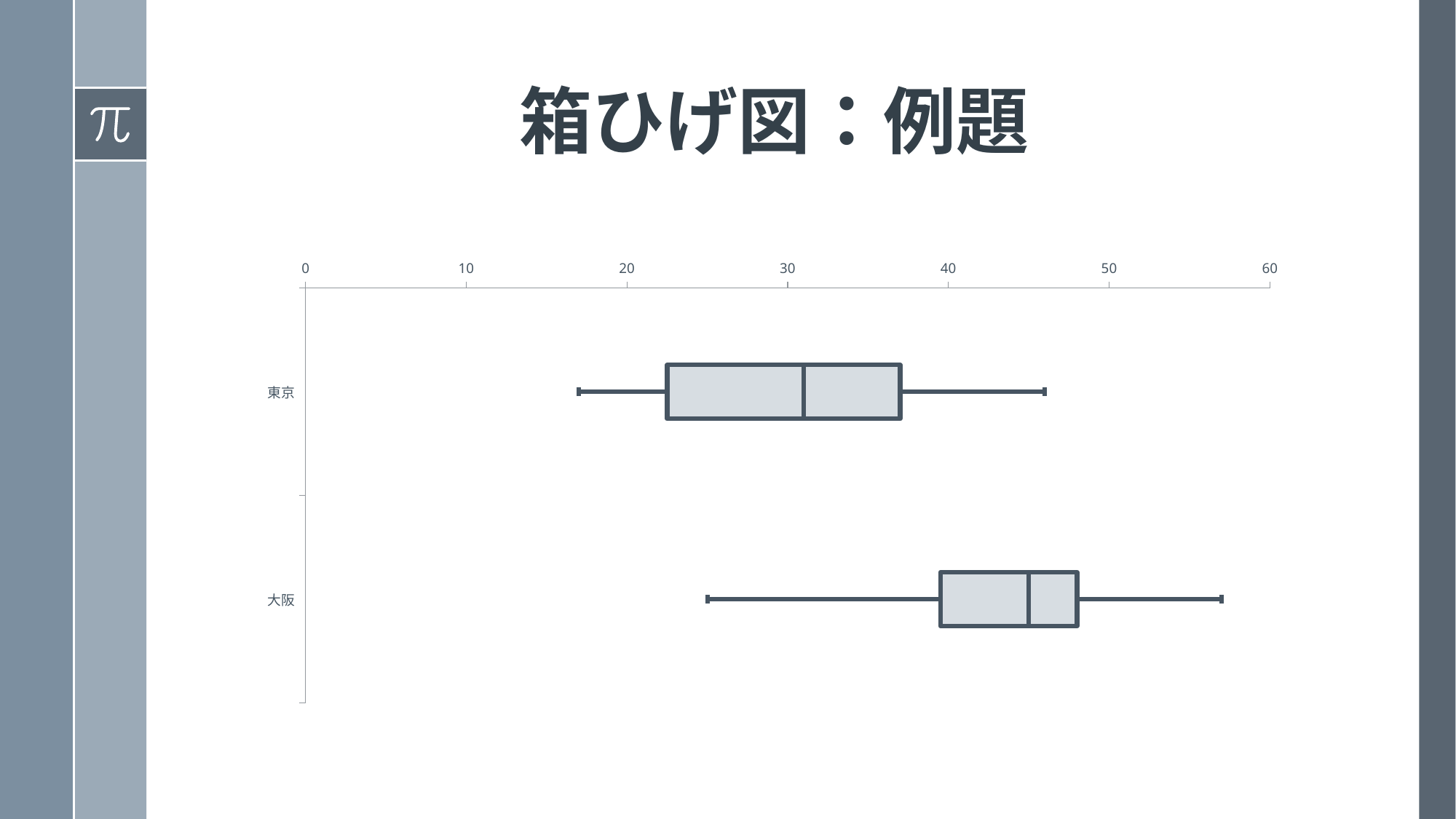
Which category has the higher median, 東京 or 大阪? 大阪 How many categories are plotted on the chart? 2 What kind of chart is shown on the slide? Box-and-whisker plot What is the highest value shown on the horizontal axis? 60 Is the maximum (right whisker end) for 東京 greater or less than 50? less Is the maximum (right whisker end) for 大阪 greater or less than 50? greater What is the title of the slide? 箱ひげ図：例題 Is the median for 東京 greater or less than 40? less Which category has the wider box (interquartile range), 東京 or 大阪? 東京